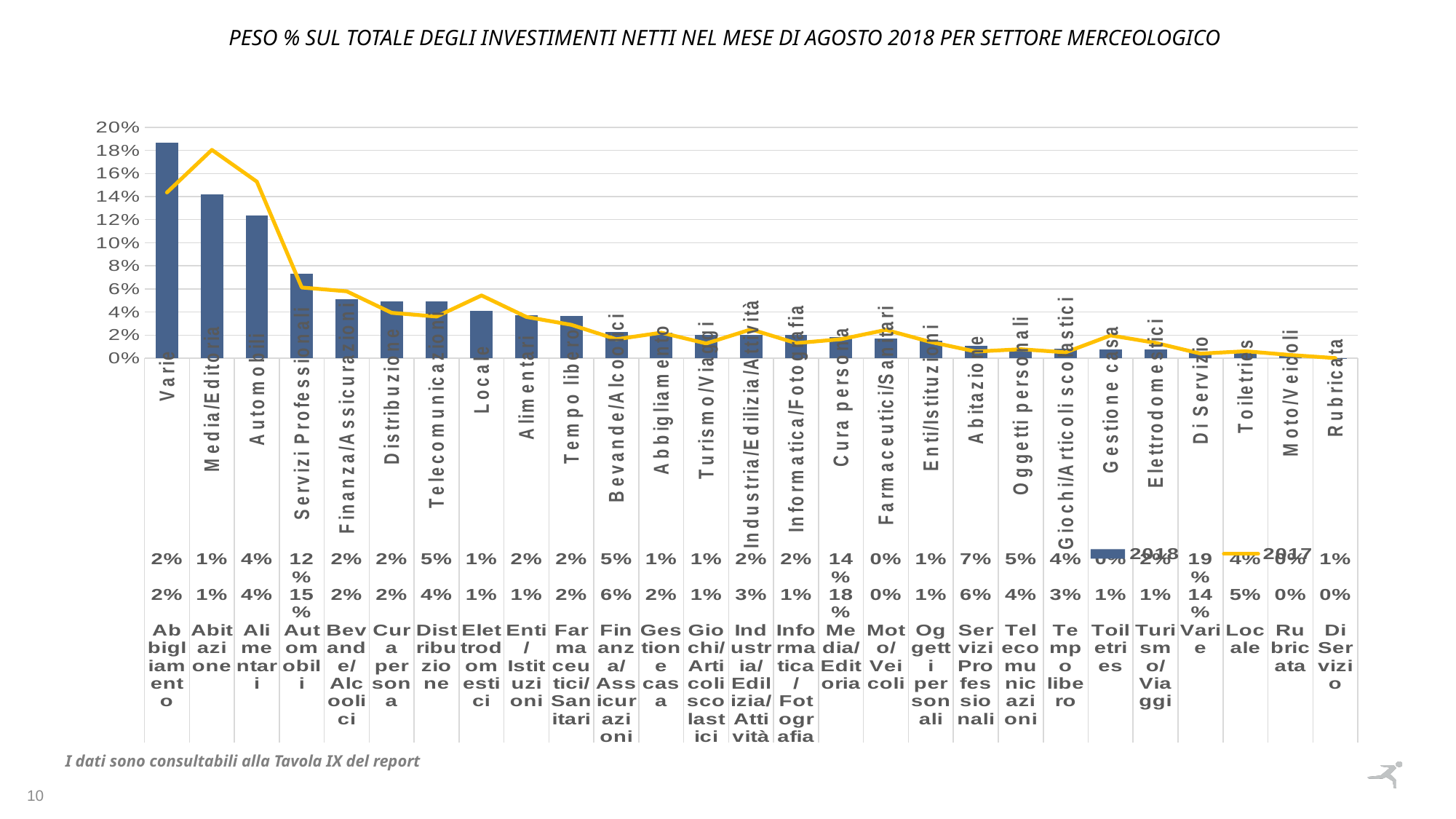
Is the 2018 bar for Servizi Professionali greater or less than 10%? less Which sector has the highest point on the 2017 line? Media/Editoria For Media/Editoria, which is higher: the 2018 bar or the 2017 line point? 2017 line point How many sectors are plotted on the x axis? 27 What are the two entries in the chart legend? 2018 and 2017 Which sector has the highest 2018 bar? Varie How many series does the legend list? 2 Is the 2018 bar for Automobili greater or less than 10%? greater Do the 2018 bars generally rise or fall from left to right along the x axis? fall Which has the taller 2018 bar, Varie or Media/Editoria? Varie What kind of chart is shown on the slide? bar chart with a line